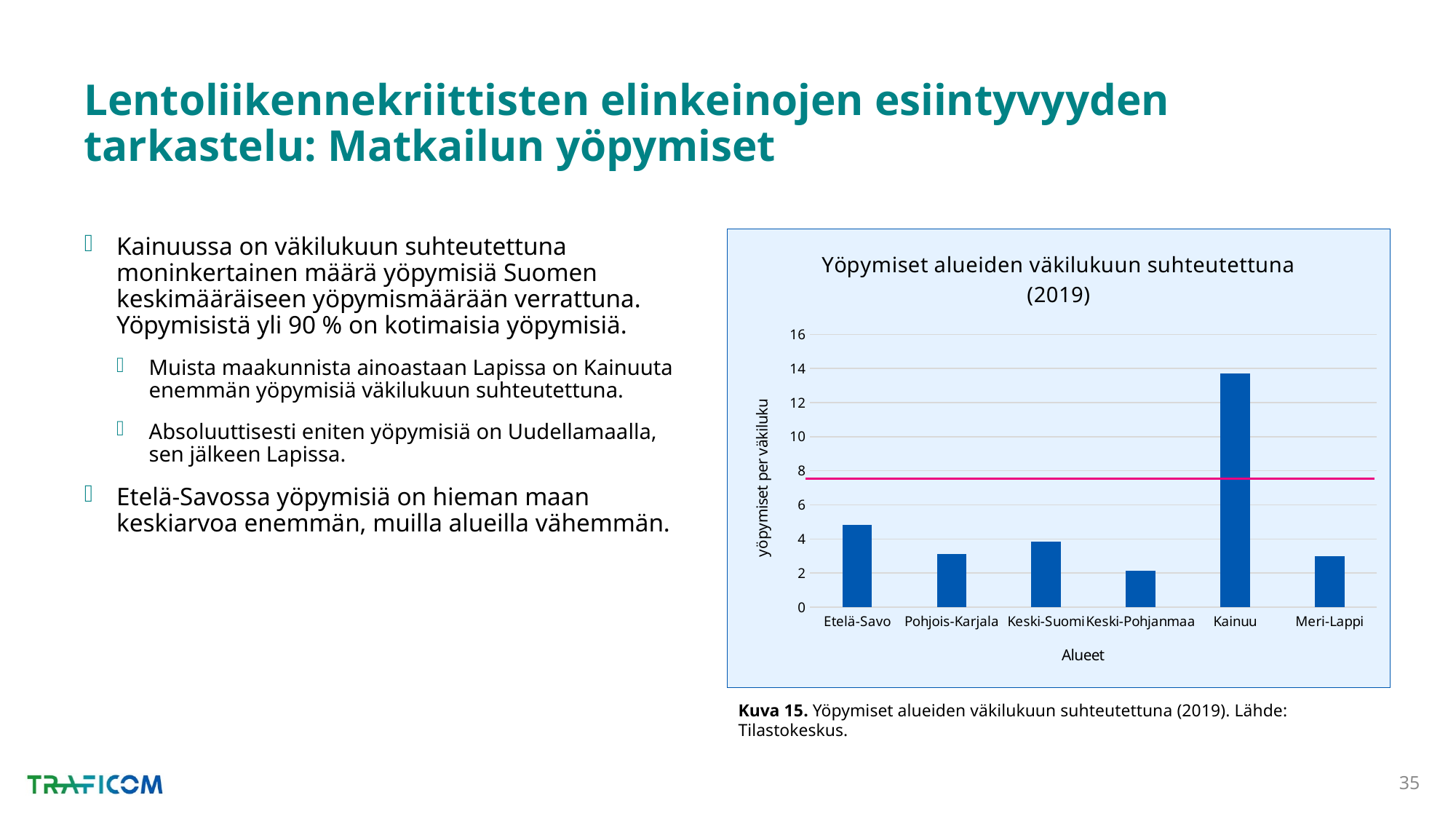
Is the value for Kainuu greater or less than 12? greater Is the value for Keski-Pohjanmaa greater or less than 4? less Which has a larger value, Etelä-Savo or Keski-Suomi? Etelä-Savo What is the label of the y axis of the chart? yöpymiset per väkiluku What kind of chart is shown on the slide? bar chart Which region has the highest value in the chart? Kainuu Which region has the lowest value in the chart? Keski-Pohjanmaa Is the value for Keski-Suomi greater or less than 2? greater What is the title of the chart? Yöpymiset alueiden väkilukuun suhteutettuna (2019) How many regions (categories) are shown on the x axis of the chart? 6